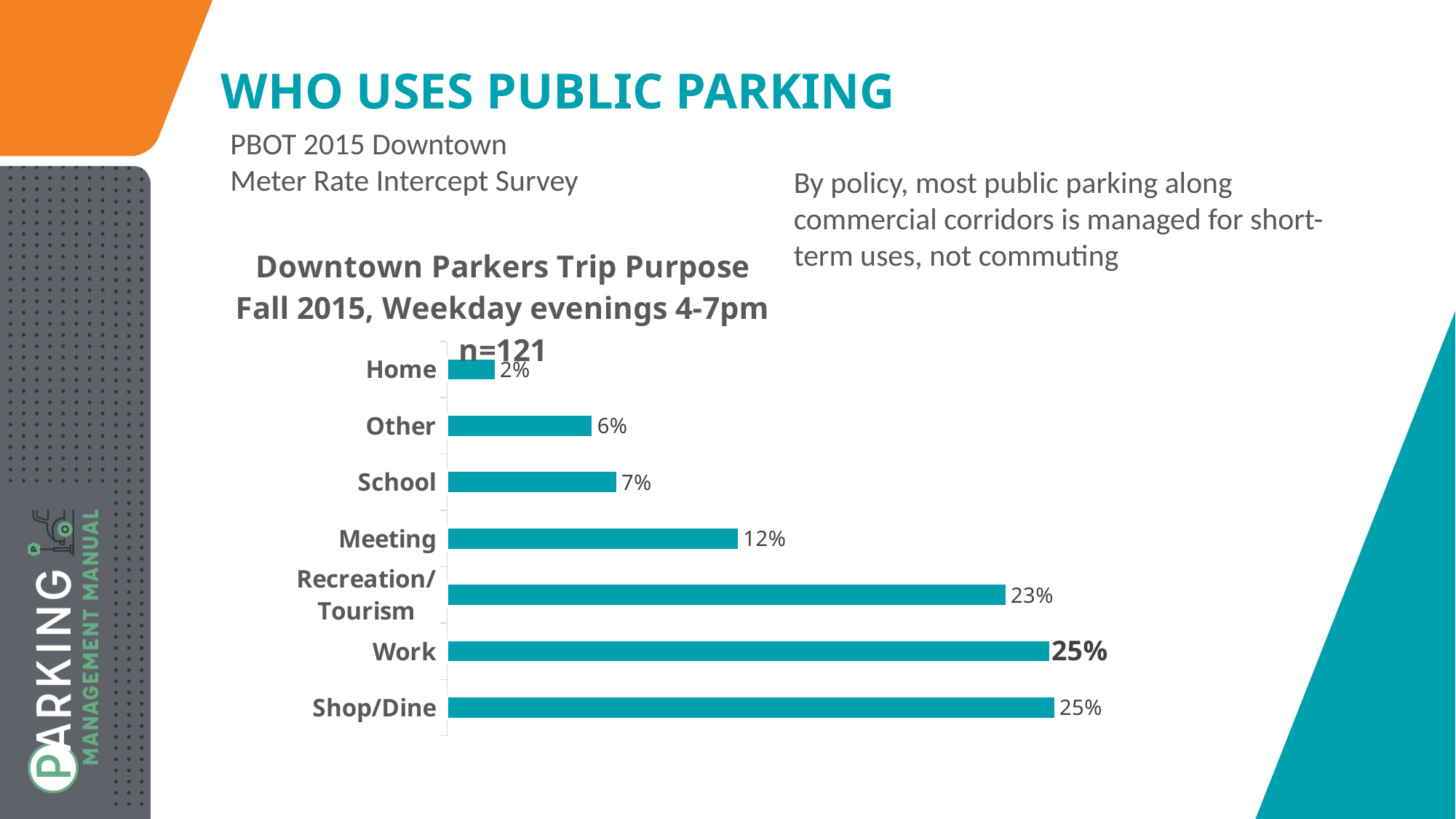
What percentage of trips were for Meeting? 12% What sample size (n) is stated in the chart title? n=121 What is the value shown for Home? 2% Which is larger, the value for Meeting or the value for School? Meeting What is the value shown for School? 7% How many trip purpose categories are shown in the chart? 7 What type of chart is used to show the Downtown Parkers Trip Purpose data? Bar chart What is the difference between the Work and Meeting values? 13% What percentage of downtown parkers reported Shop/Dine as their trip purpose? 25% What is the value for Recreation/Tourism in the Downtown Parkers Trip Purpose chart? 23% What is the difference between the Recreation/Tourism and Other values? 17% Which trip purpose has the lowest share in the chart? Home